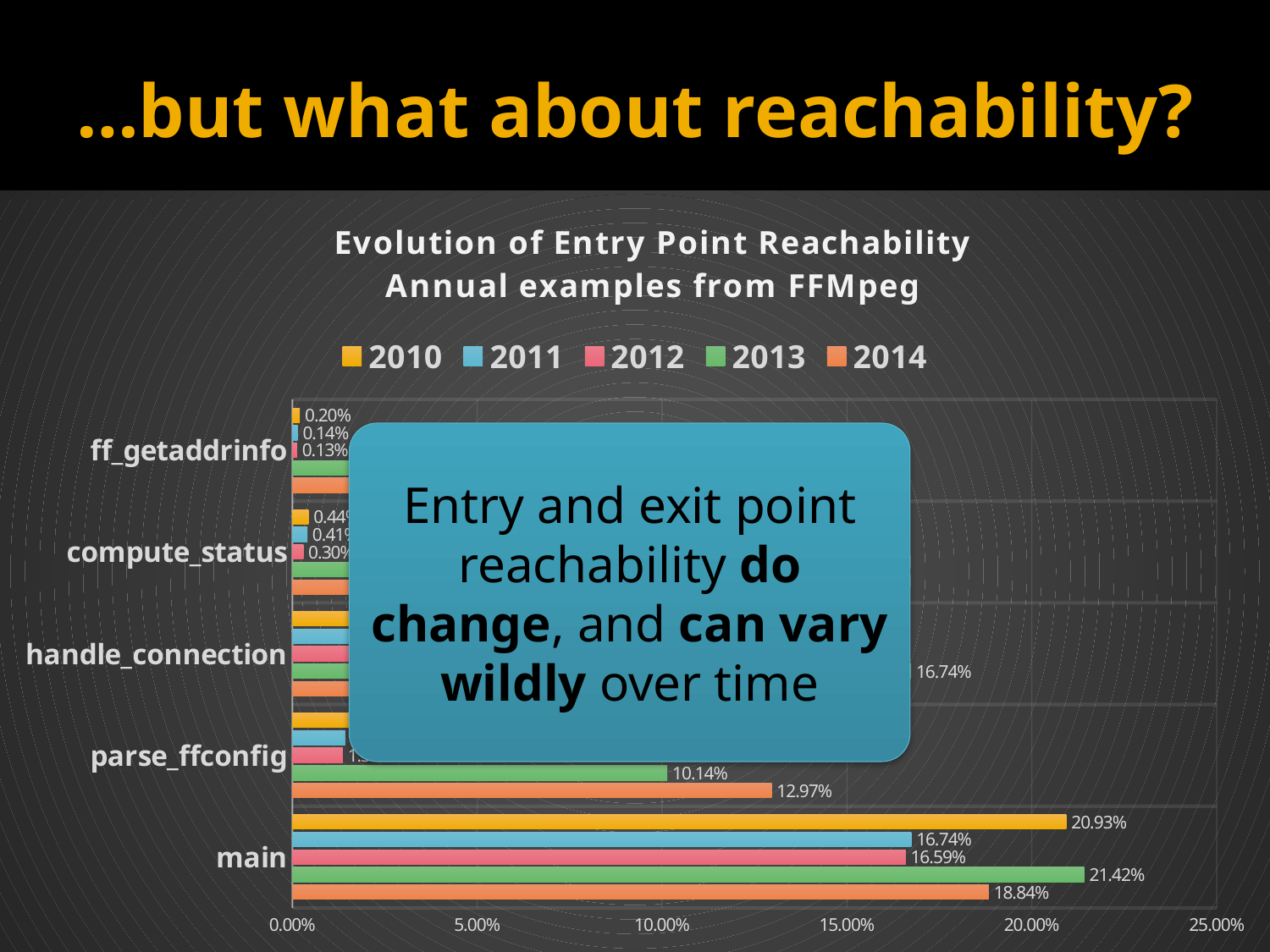
How many entry point categories are shown on the y axis? 5 What is the 2013 value for parse_ffconfig? 10.14% Is the 2014 value for main greater or less than 15.00%? greater What is the difference between the 2013 and 2014 values for main? 2.58% What is the 2010 value for main? 20.93% What is the 2014 value for parse_ffconfig? 12.97% What is the 2010 value for ff_getaddrinfo? 0.20% What is the 2013 value for main? 21.42% What kind of chart is shown on the slide? bar chart Which year has the lowest value for main? 2012 How many series does the legend list? 5 Which year has the highest value for main? 2013